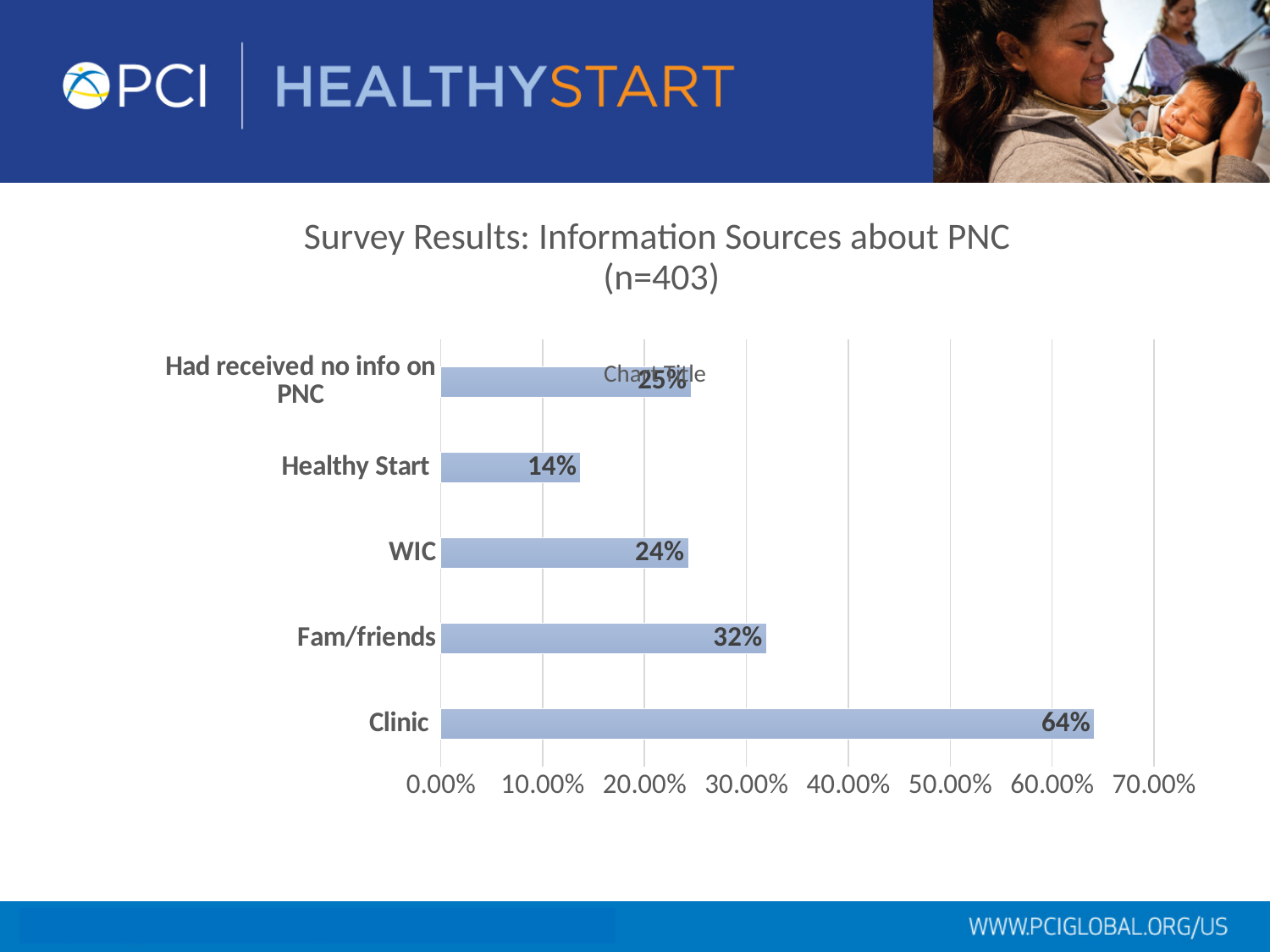
What is the sample size stated in the slide title? n=403 What is the value shown for WIC? 24% What kind of chart is shown on the slide? Bar chart What percentage of respondents cited Clinic as an information source about PNC? 64% How many categories are shown in the chart? 5 What is the difference between the Clinic value and the Fam/friends value? 32% What is the value shown for Fam/friends? 32% What is the value shown for Healthy Start? 14% Which category has the lowest value? Healthy Start Which is larger, the value for WIC or the value for Healthy Start? WIC Is the value for Fam/friends greater or less than 30.00%? greater Which category has the highest value? Clinic